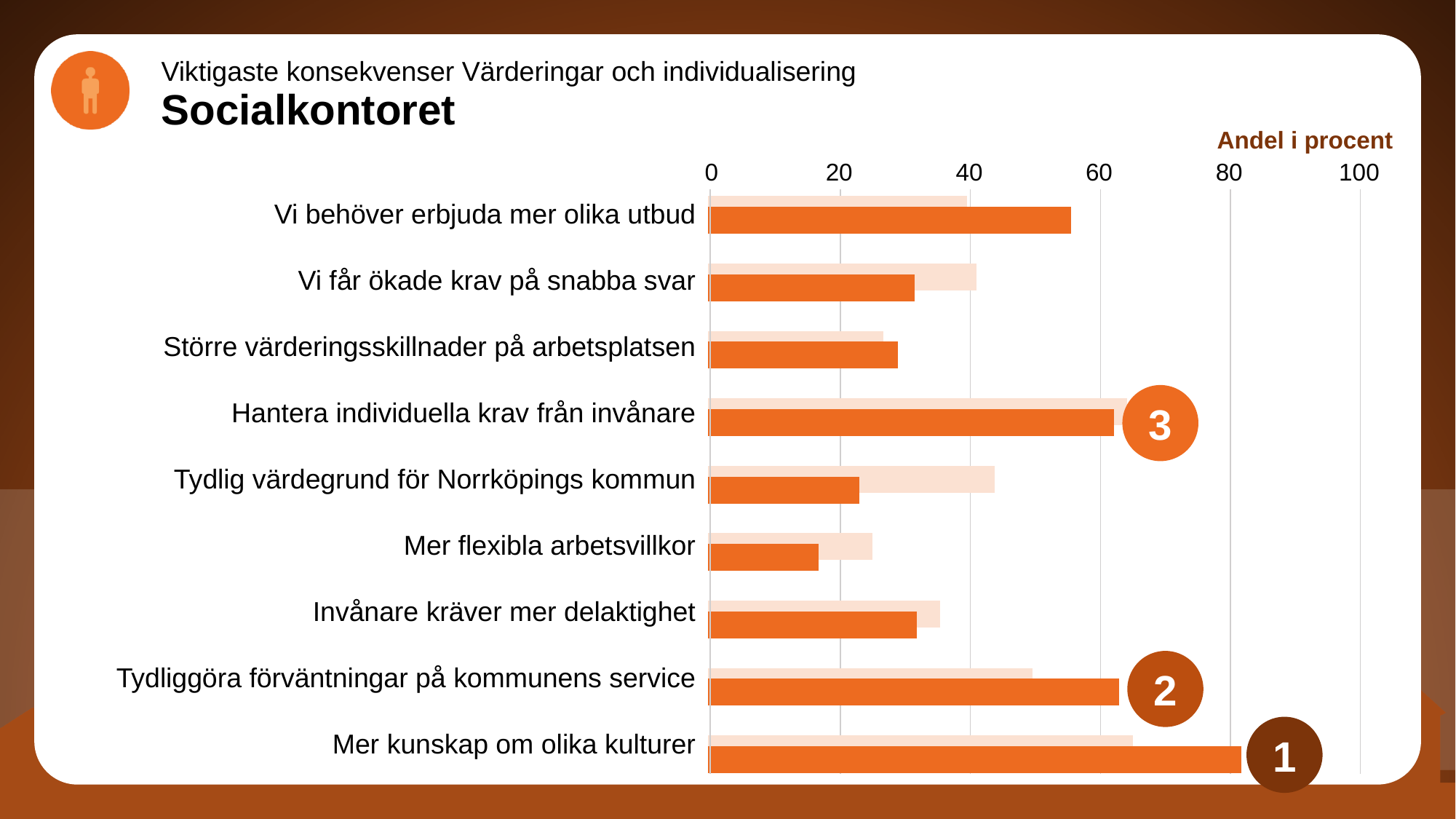
Which category has the longest dark orange bar? Mer kunskap om olika kulturer Which has the larger dark orange value: Vi behöver erbjuda mer olika utbud or Vi får ökade krav på snabba svar? Vi behöver erbjuda mer olika utbud How many categories are shown on the chart? 9 Is the dark orange value for Mer kunskap om olika kulturer greater or less than 80? greater Is the dark orange value for Vi behöver erbjuda mer olika utbud greater or less than 60? less Which category is marked with the circled number 1? Mer kunskap om olika kulturer What kind of chart is shown on the slide? bar chart Is the light orange value for Tydliggöra förväntningar på kommunens service greater or less than 40? greater Which category has the shortest dark orange bar? Mer flexibla arbetsvillkor What label is shown above the horizontal axis of the chart? Andel i procent